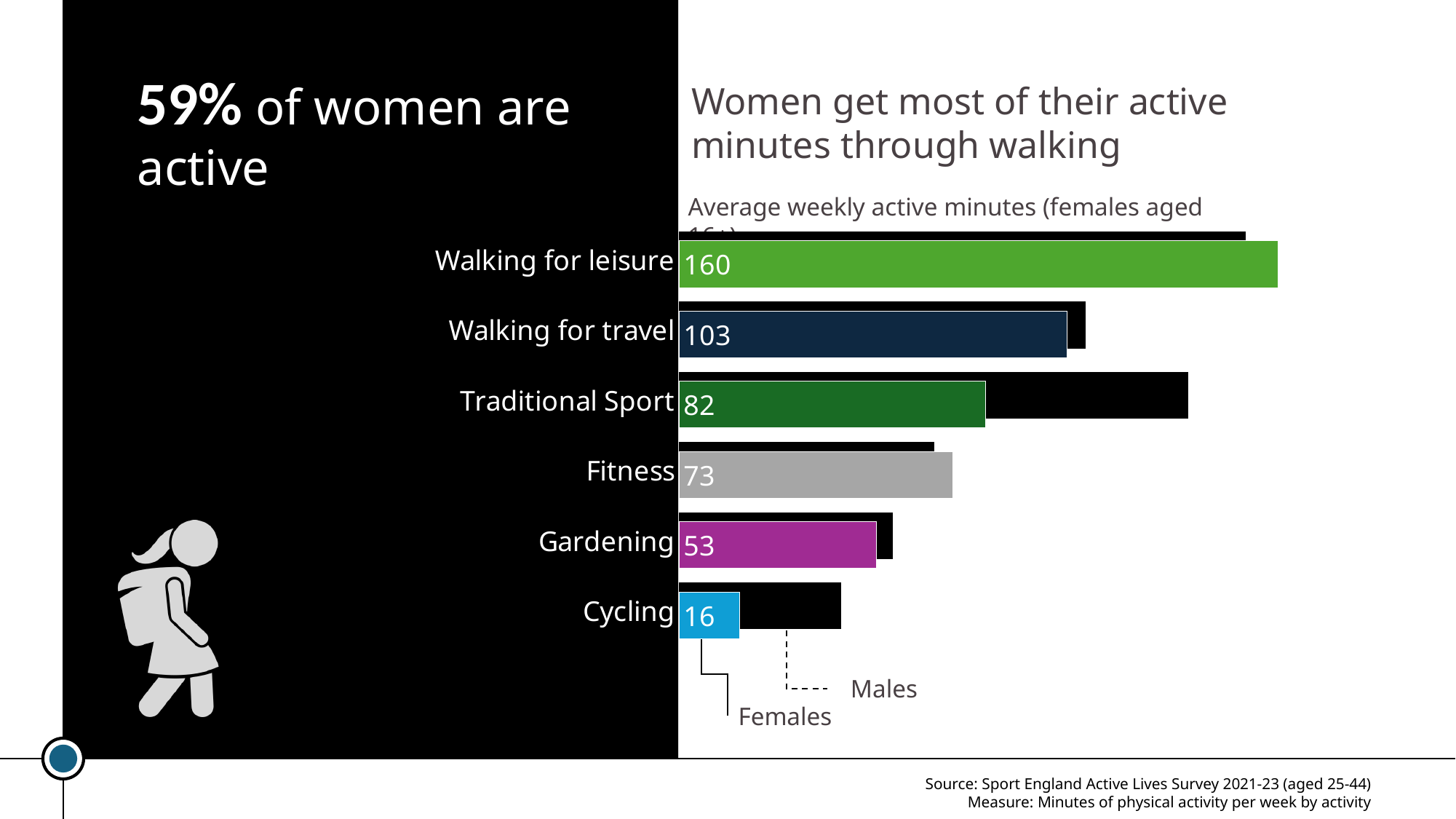
For Traditional Sport, is the Males bar or the Females bar longer? Males How many activities are shown in the chart? 6 Which activity has the highest average weekly active minutes for females? Walking for leisure What is the average weekly active minutes for females for Walking for travel? 103 For Walking for leisure, is the Males bar or the Females bar longer? Females What is the average weekly active minutes for females for Traditional Sport? 82 What is the difference between the female values for Walking for leisure and Walking for travel? 57 What is the difference between the female values for Fitness and Cycling? 57 Which activity has the lowest average weekly active minutes for females? Cycling What is the average weekly active minutes for females for Walking for leisure? 160 How many series does the legend list? 2 What is the average weekly active minutes for females for Gardening? 53